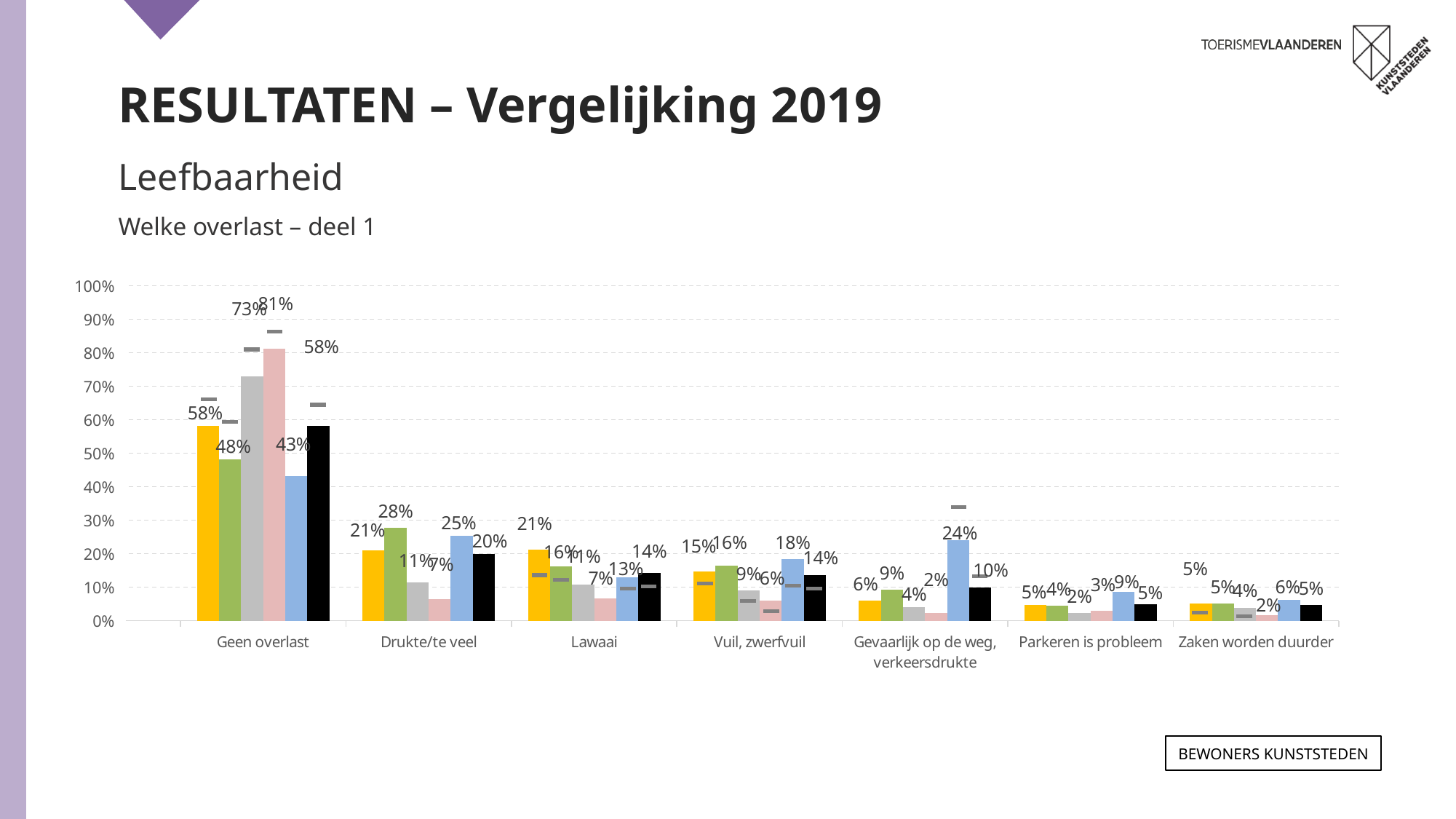
Which is larger for 'Drukte/te veel': the yellow bar or the blue bar? the blue bar (25%) What is the value of the black bar for 'Lawaai'? 14% What is the subtitle printed directly above the chart? Welke overlast – deel 1 What is the value of the blue bar for 'Gevaarlijk op de weg, verkeersdrukte'? 24% Which bar is the highest within the 'Geen overlast' category? the pink bar (81%) What is the value of the green bar for 'Drukte/te veel'? 28% How many categories are shown along the x axis of the chart? 7 Is the value of the grey bar for 'Geen overlast' greater or less than 70%? greater What is the value of the pink bar for 'Geen overlast'? 81% What is the difference between the pink bar (81%) and the blue bar (43%) for 'Geen overlast'? 38 percentage points Which category has the highest bars overall in the chart? Geen overlast What kind of chart is shown on the slide? bar chart